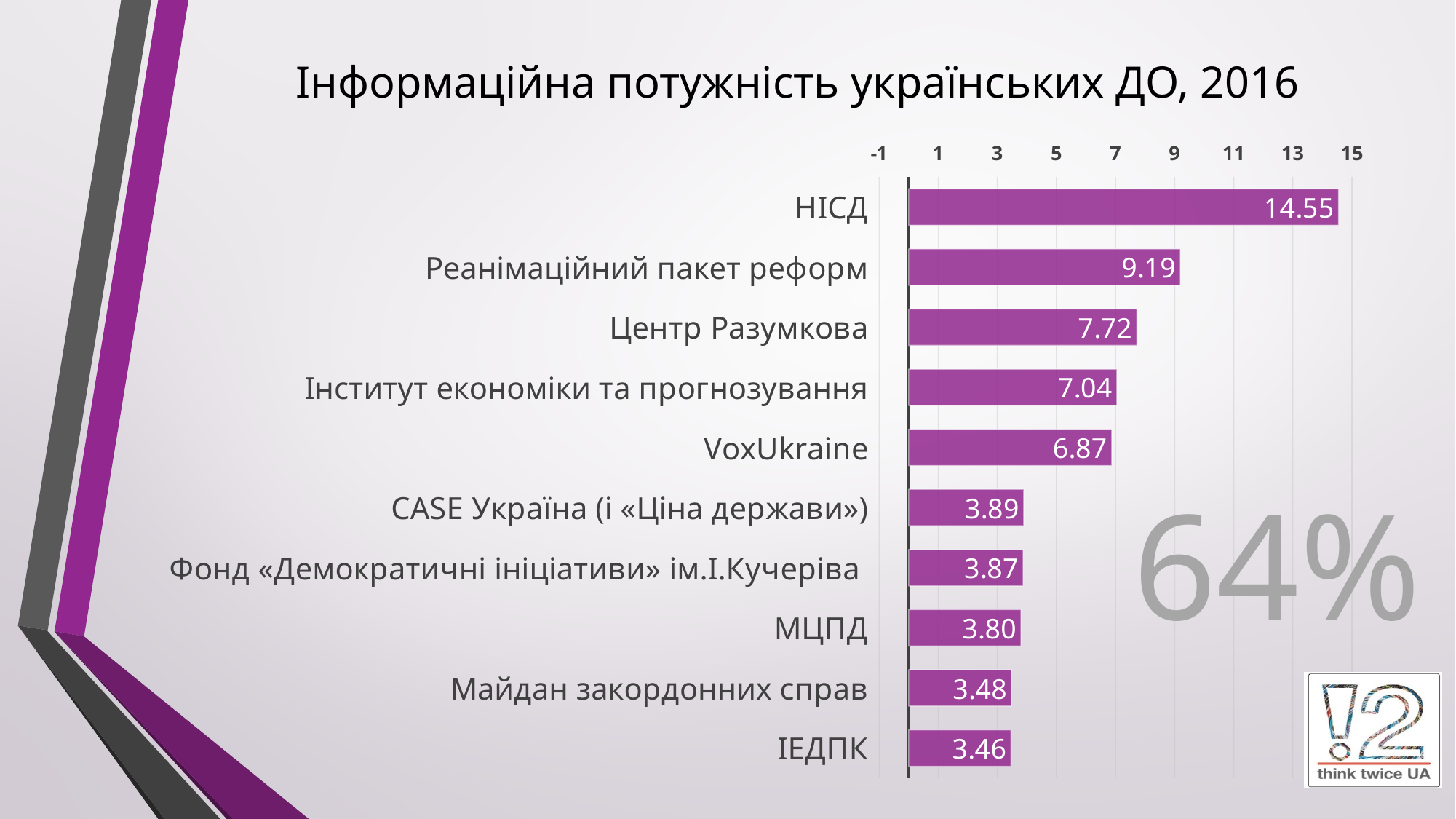
Which category has the lowest value? ІЕДПК What is the title of the chart? Інформаційна потужність українських ДО, 2016 How many categories are shown in the chart? 10 What kind of chart is shown on the slide? bar chart What is the value for НІСД? 14.55 What is the difference between the values for НІСД and Реанімаційний пакет реформ? 5.36 Which is larger, the value for Інститут економіки та прогнозування or the value for VoxUkraine? Інститут економіки та прогнозування Which category has the highest value? НІСД What is the value for Майдан закордонних справ? 3.48 What is the value for Центр Разумкова? 7.72 What is the value for VoxUkraine? 6.87 Is the value for Реанімаційний пакет реформ greater or less than 7? greater